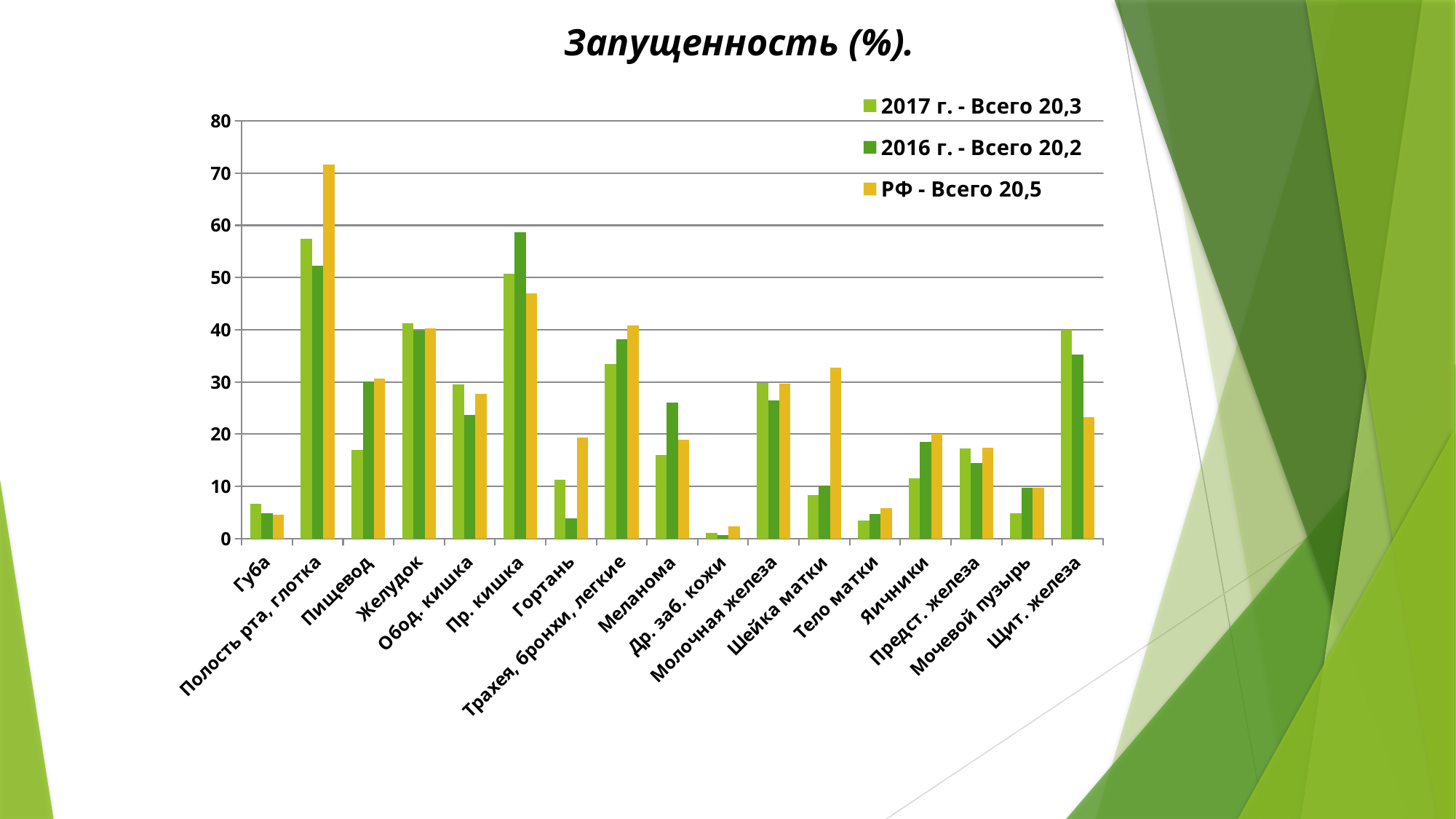
Is the РФ value for Полость рта, глотка greater or less than 60? greater How many series does the legend list? 3 For Меланома, which is larger: the 2016 г. value or the 2017 г. value? 2016 г. Is the 2017 г. value for Гортань greater or less than 20? less Which category has the highest value for the 2016 г. series? Пр. кишка Is the 2016 г. value for Пр. кишка greater or less than 50? greater How many categories are shown on the x axis? 17 For Шейка матки, which is larger: the РФ value or the 2017 г. value? РФ What kind of chart is shown on the slide? bar chart Which category has the highest value for the РФ series? Полость рта, глотка Which category has the lowest value for the 2017 г. series? Др. заб. кожи What is the title of the chart? Запущенность (%).